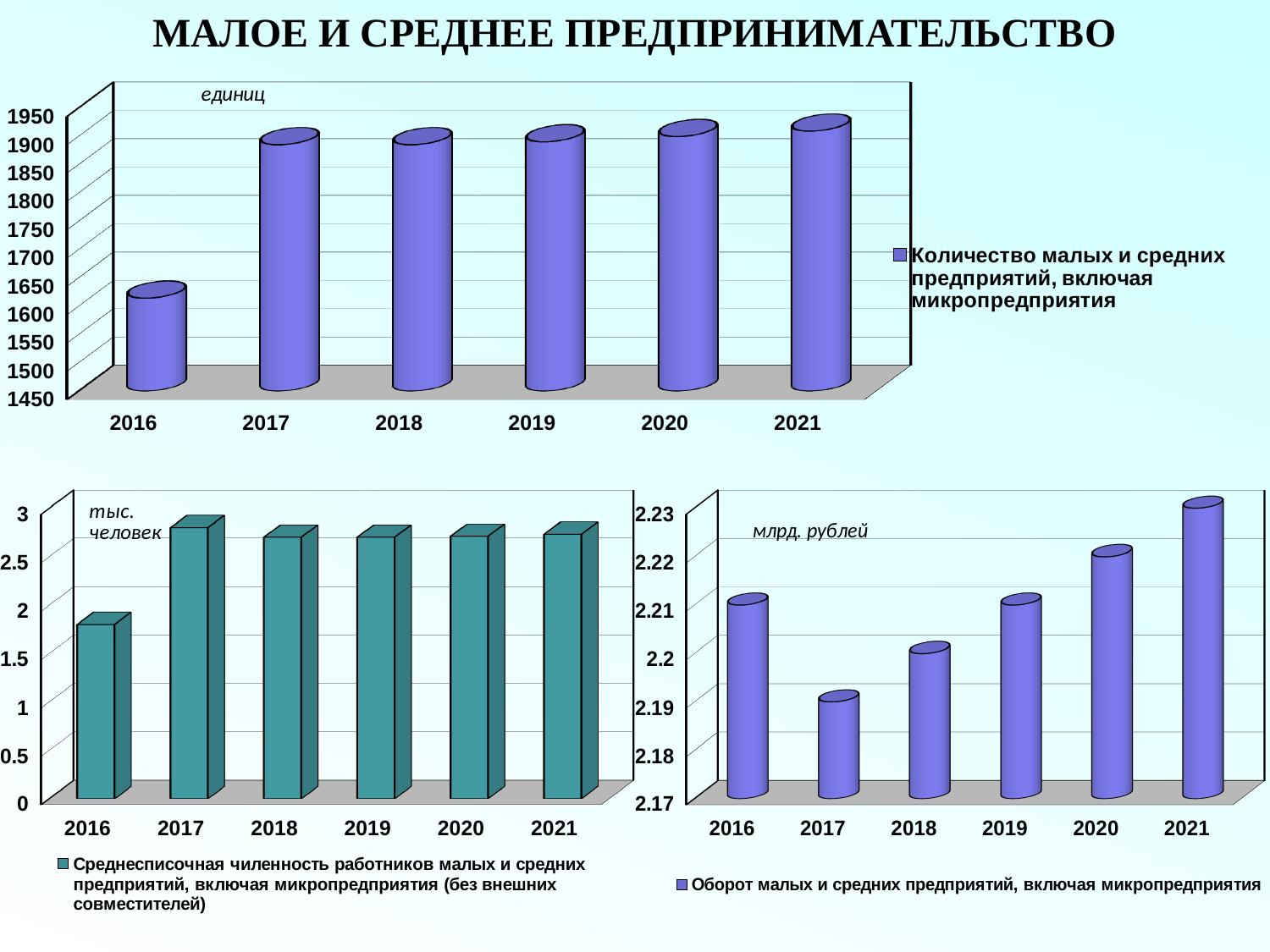
In the top chart (единиц), which year has the lowest value? 2016 In the bottom-right chart (млрд. рублей), which year has the lowest value? 2017 In the bottom-right chart (млрд. рублей), which year has the highest value? 2021 How many years are shown on the x axis of the top chart (единиц)? 6 In the bottom-right chart (млрд. рублей), is the value for 2017 greater or less than 2.2? less In the bottom-left chart (тыс. человек), is the value for 2016 greater or less than 2? less In the bottom-left chart (тыс. человек), which year has the lowest value? 2016 In the bottom-right chart (млрд. рублей), do the values rise or fall from 2017 to 2021? rise What kind of chart is the bottom-right chart (млрд. рублей)? bar chart In the top chart (единиц), is the value for 2016 greater or less than 1700? less In the bottom-left chart (тыс. человек), which is larger, the value for 2016 or the value for 2017? 2017